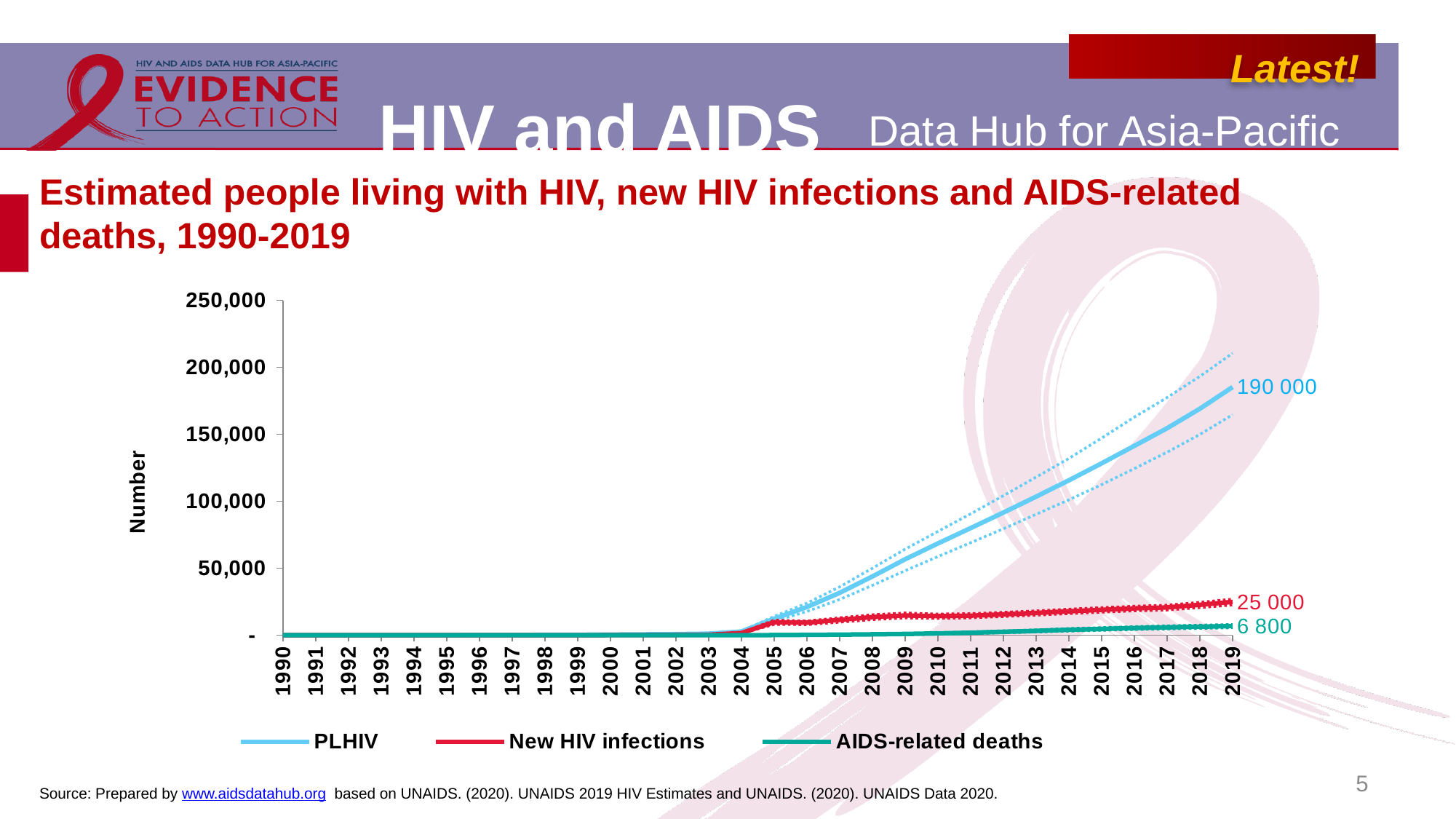
How many series does the legend list? 3 What is the difference between New HIV infections and AIDS-related deaths in 2019? 18 200 Is the value for PLHIV in 2019 greater or less than 200,000? less What kind of chart is shown on the slide? line chart What is the value for New HIV infections in 2019? 25 000 What is the value for AIDS-related deaths in 2019? 6 800 What is the difference between PLHIV and New HIV infections in 2019? 165 000 Which series has the highest value in 2019? PLHIV How many years are shown on the x axis? 30 Is the value for PLHIV in 2015 greater or less than 100,000? greater Which series has the lowest value in 2019? AIDS-related deaths What is the value for PLHIV in 2019? 190 000